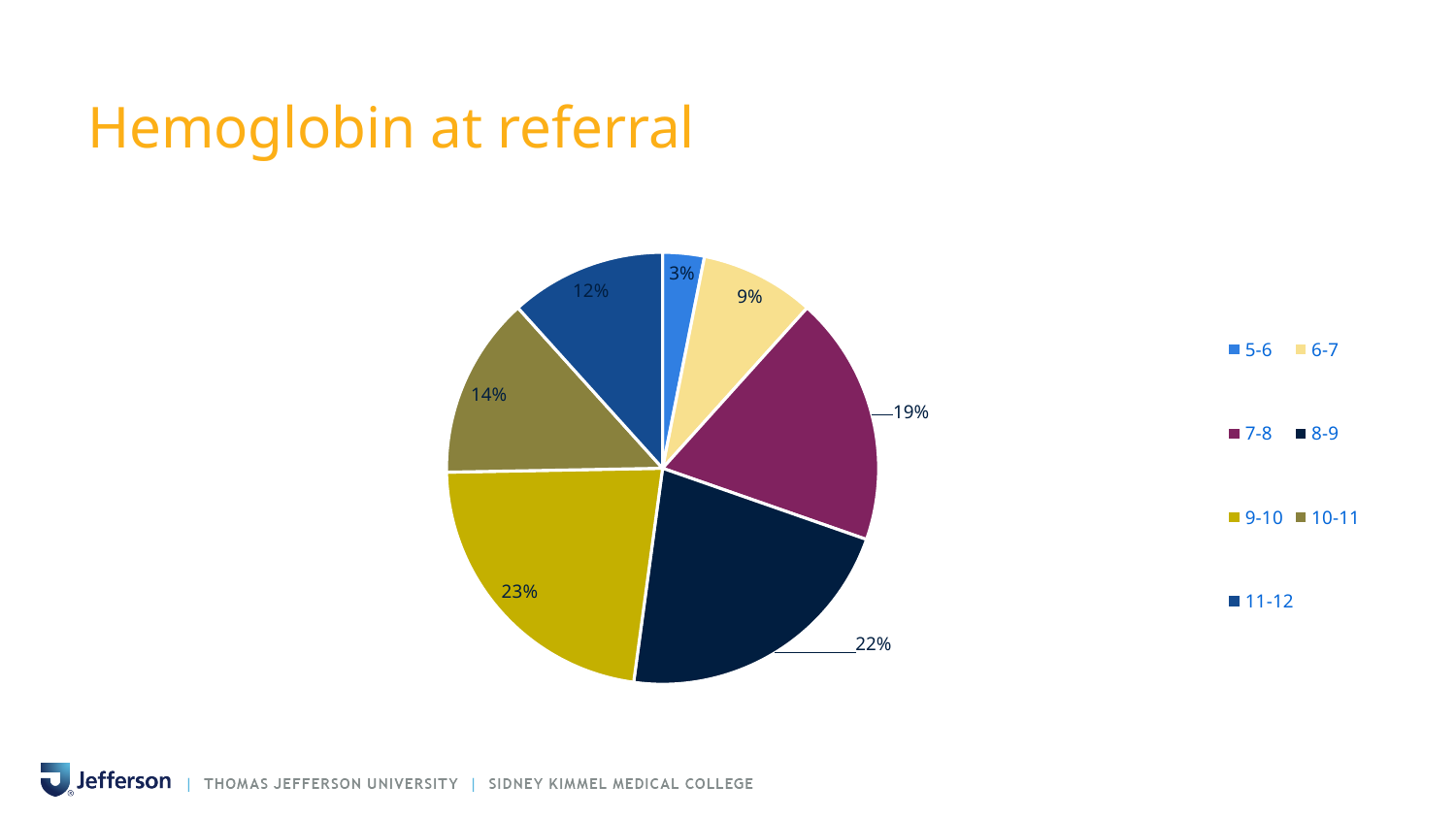
Which category has the smallest slice? 5-6 What is the difference in percentage points between the 8-9 slice and the 6-7 slice? 13 What share of the pie is the 9-10 slice? 23% Which slice is larger, 11-12 or 10-11? 10-11 Which category has the largest slice? 9-10 What kind of chart is shown on the slide? pie chart What share of the pie is the 7-8 slice? 19% What share of the pie is the 10-11 slice? 14% How many categories does the legend list? 7 What is the title of the chart? Hemoglobin at referral